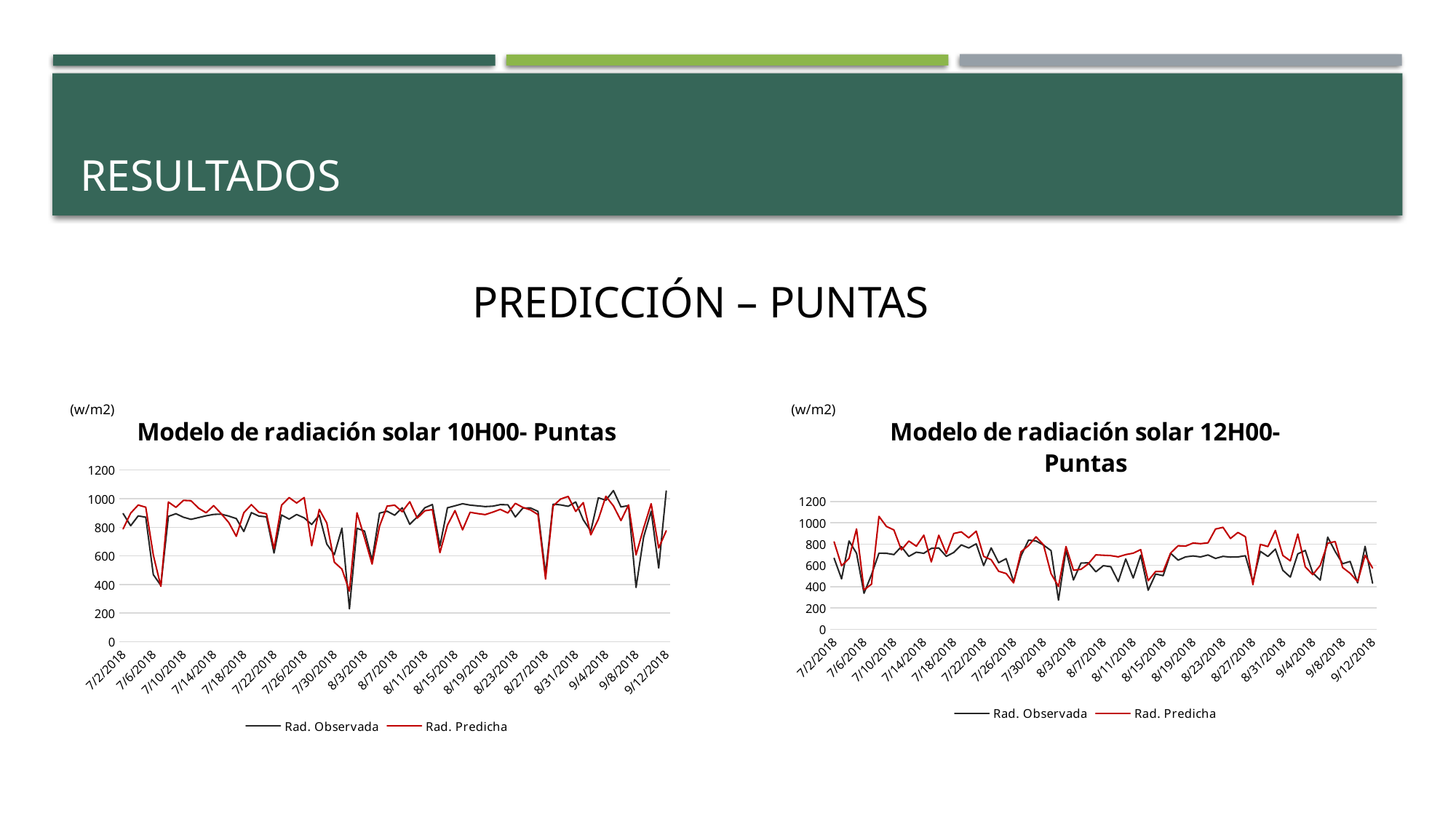
In the 'Modelo de radiación solar 12H00- Puntas' chart, is the highest value of Rad. Predicha (around 7/9/2018) greater or less than 1000? greater In the 'Modelo de radiación solar 10H00- Puntas' chart, which series is drawn in red? Rad. Predicha What unit is shown above the y axis of the 'Modelo de radiación solar 12H00- Puntas' chart? (w/m2) What kind of chart is the 'Modelo de radiación solar 10H00- Puntas' chart? line chart What is the highest tick value shown on the y axis of the 'Modelo de radiación solar 10H00- Puntas' chart? 1200 What kind of chart is the 'Modelo de radiación solar 12H00- Puntas' chart? line chart How many series does the legend of the 'Modelo de radiación solar 12H00- Puntas' chart list? 2 How many date labels are shown on the x axis of the 'Modelo de radiación solar 12H00- Puntas' chart? 19 In the 'Modelo de radiación solar 10H00- Puntas' chart, is the lowest value of Rad. Observada (around 8/1/2018) greater or less than 400? less How many series does the legend of the 'Modelo de radiación solar 10H00- Puntas' chart list? 2 In the 'Modelo de radiación solar 12H00- Puntas' chart, is the lowest value of Rad. Observada (around 8/2/2018) greater or less than 400? less